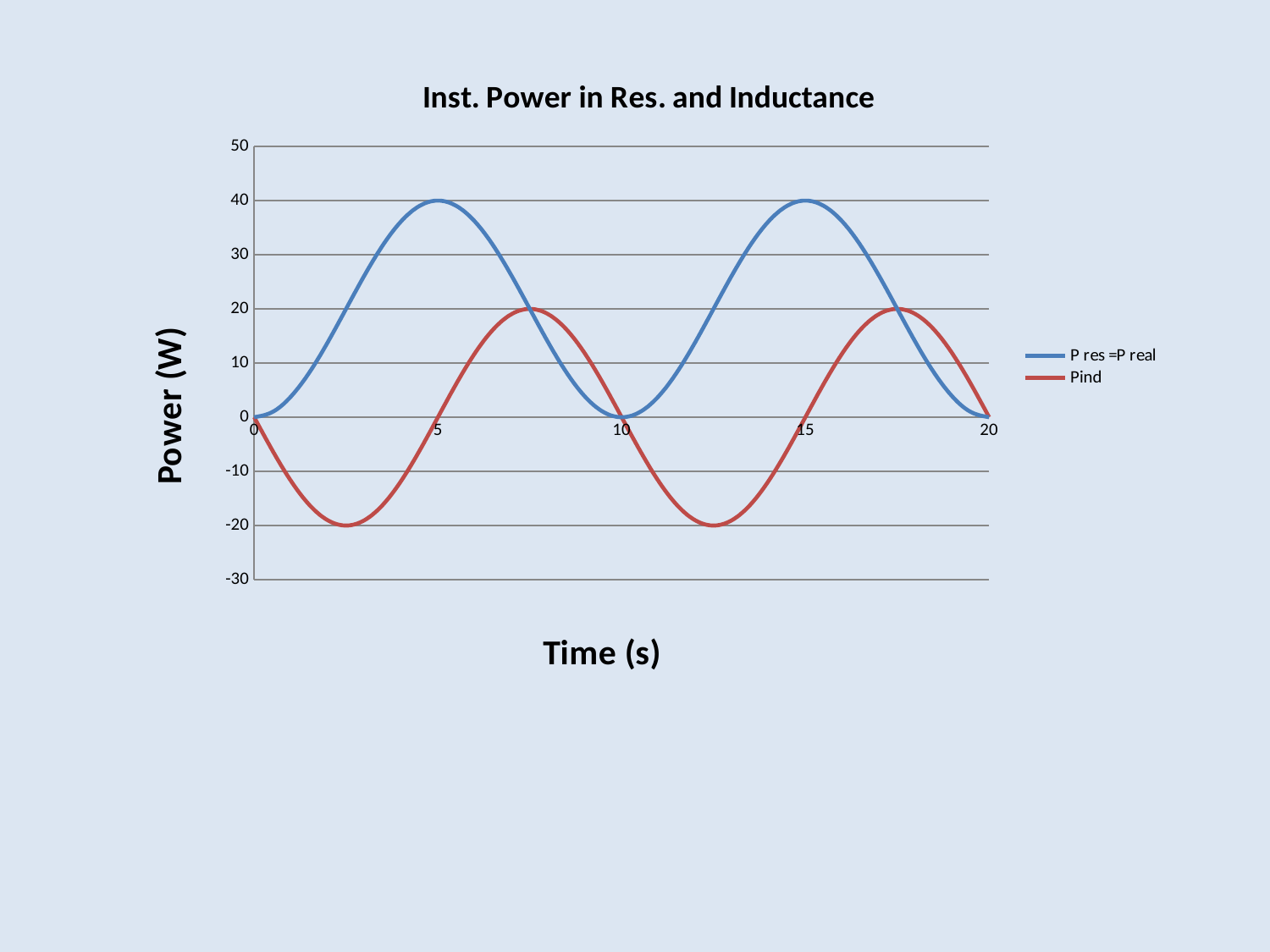
Is the value of Pind at time 2.5 s greater or less than 0? less What kind of chart is shown on the slide? line chart What is the title of the chart? Inst. Power in Res. and Inductance What is the value of Pind at time 5 s? 0 Does the P res =P real series rise or fall between time 0 s and time 5 s? rise Which series reaches the higher peak value, P res =P real or Pind? P res =P real What is the maximum value reached by the P res =P real series? 40 What is the value of P res =P real at time 10 s? 0 What is the label of the y axis? Power (W) How many series does the legend list? 2 What is the minimum value reached by the Pind series? -20 What is the value of P res =P real at time 5 s? 40